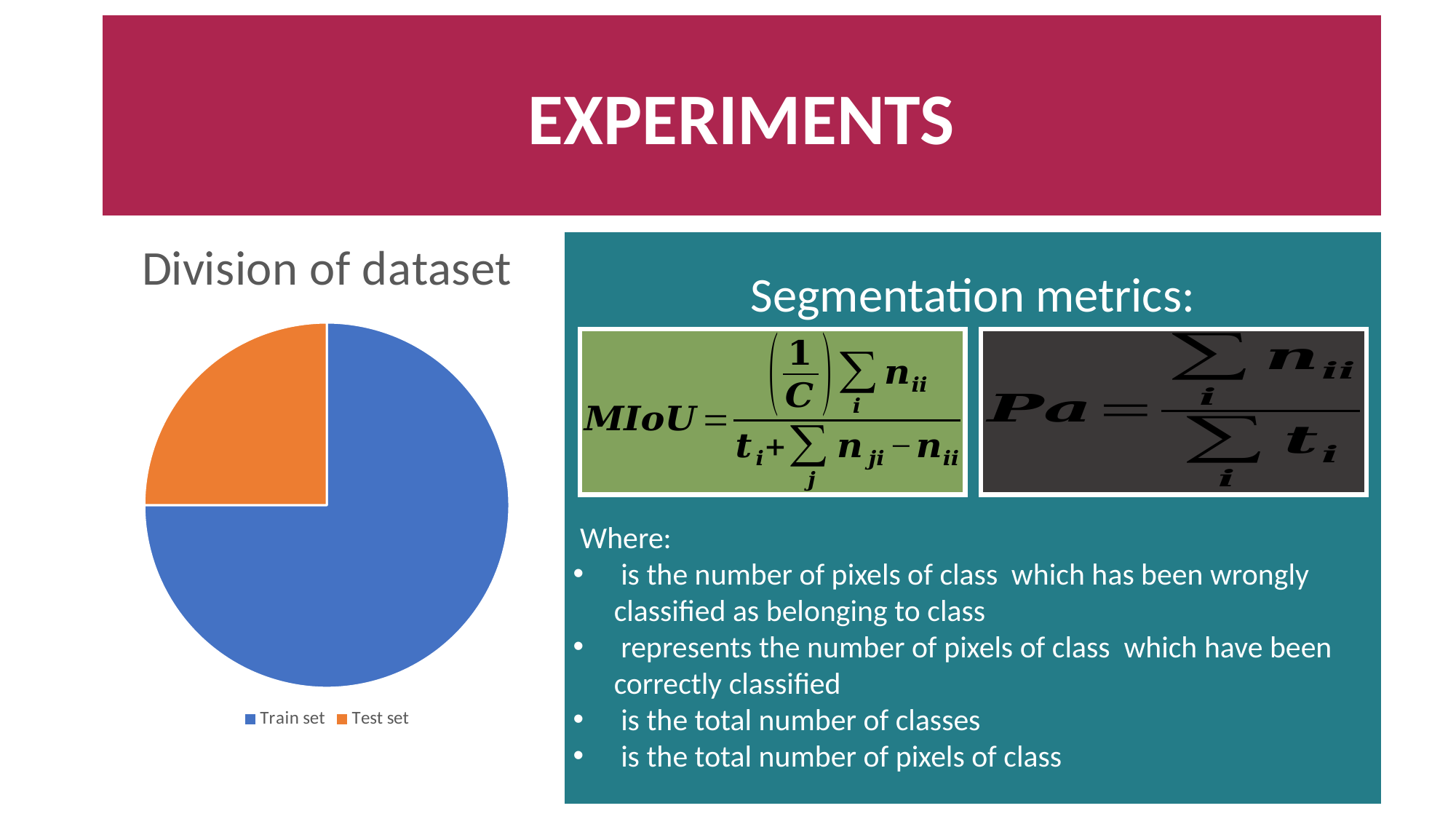
What kind of chart is shown under the title "Division of dataset"? Pie chart What is the title of the chart on the left of the slide? Division of dataset Which category takes the smallest share of the "Division of dataset" pie chart? Test set Which category takes the largest share of the "Division of dataset" pie chart? Train set How many slices does the "Division of dataset" pie chart have? 2 How many entries does the legend of the "Division of dataset" pie chart list? 2 In the "Division of dataset" pie chart, which is larger, the Train set slice or the Test set slice? Train set What are the two categories listed in the legend of the "Division of dataset" pie chart? Train set and Test set In the "Division of dataset" pie chart, what colour is the Test set slice? Orange